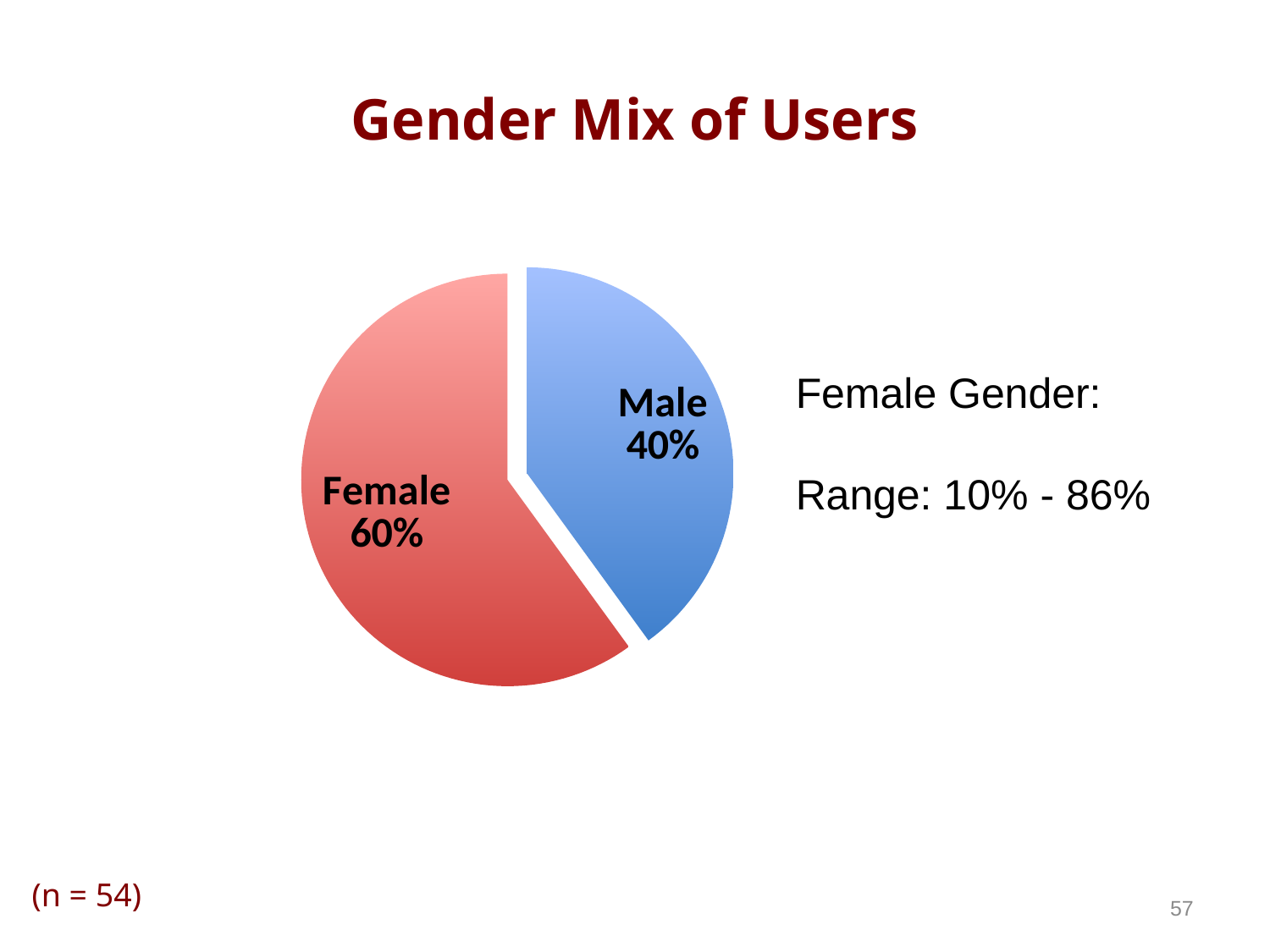
Which gender has the smaller share of users? Male What percentage of users are Male? 40% Is the Female share larger or smaller than the Male share? larger How many slices does the pie chart have? 2 What percentage of users are Female? 60% What share of the pie does the Male slice represent? 40% Which gender has the larger share of users? Female What is the title of the chart? Gender Mix of Users What kind of chart is shown on the slide? pie chart What is the difference in percentage points between the Female and Male shares? 20 What colour is the Female slice of the pie chart? red